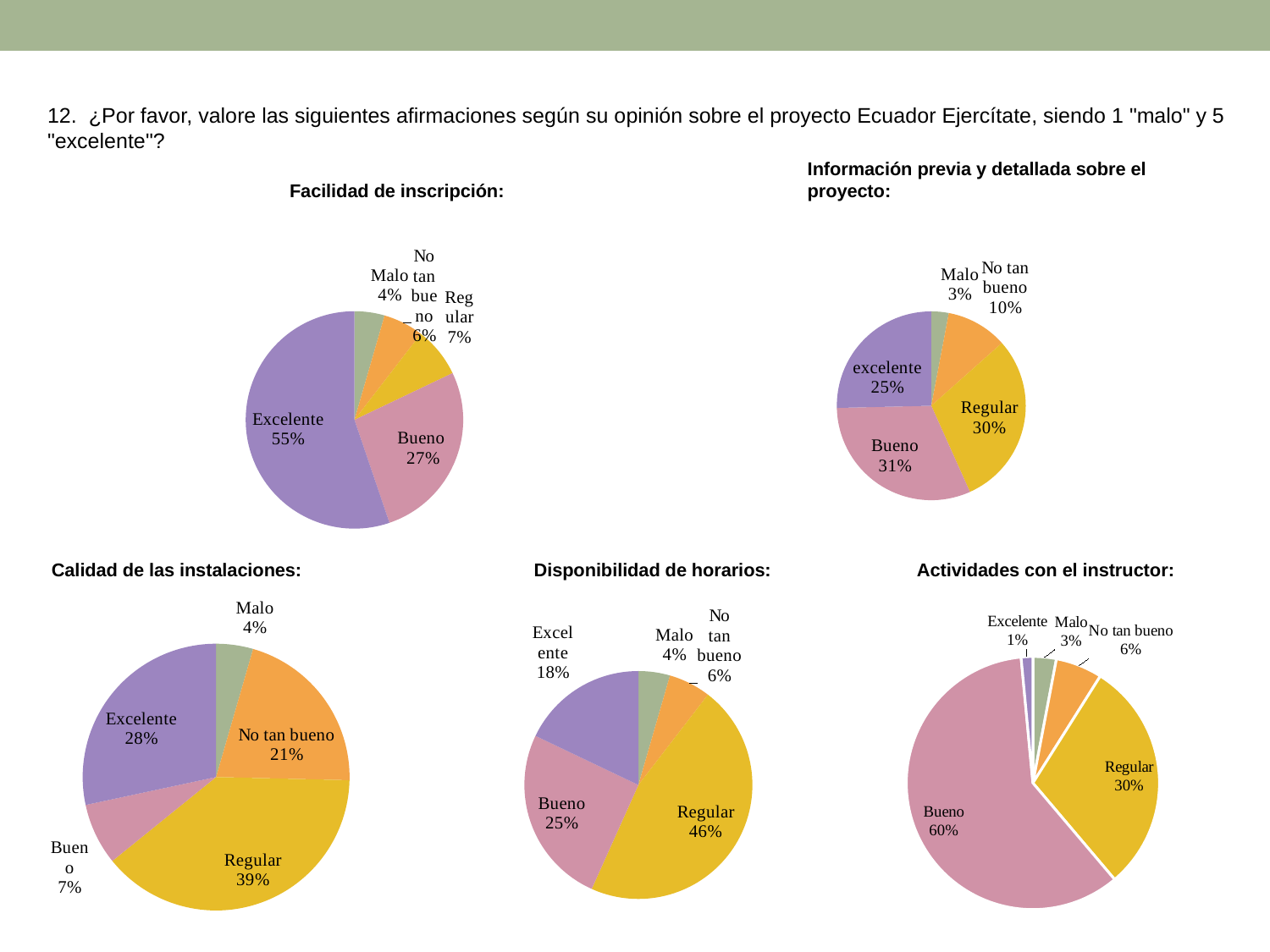
In the 'Actividades con el instructor' chart, which category has the largest share? Bueno In the 'Calidad de las instalaciones' chart, what share is labelled No tan bueno? 21% In the 'Actividades con el instructor' chart, what share is labelled Excelente? 1% In the 'Disponibilidad de horarios' chart, what share is labelled Regular? 46% How many pie charts are shown on the slide? 5 In the 'Información previa y detallada sobre el proyecto' chart, what share is labelled Regular? 30% In the 'Facilidad de inscripción' chart, which category has the smallest share? Malo In the 'Información previa y detallada sobre el proyecto' chart, what is the difference between the Bueno and excelente shares? 6% In the 'Disponibilidad de horarios' chart, what is the difference between the Bueno and Excelente shares? 7% In the 'Calidad de las instalaciones' chart, which category has the largest share? Regular In the 'Facilidad de inscripción' chart, what share is labelled Excelente? 55% In the 'Calidad de las instalaciones' chart, which is larger, Excelente or Bueno? Excelente